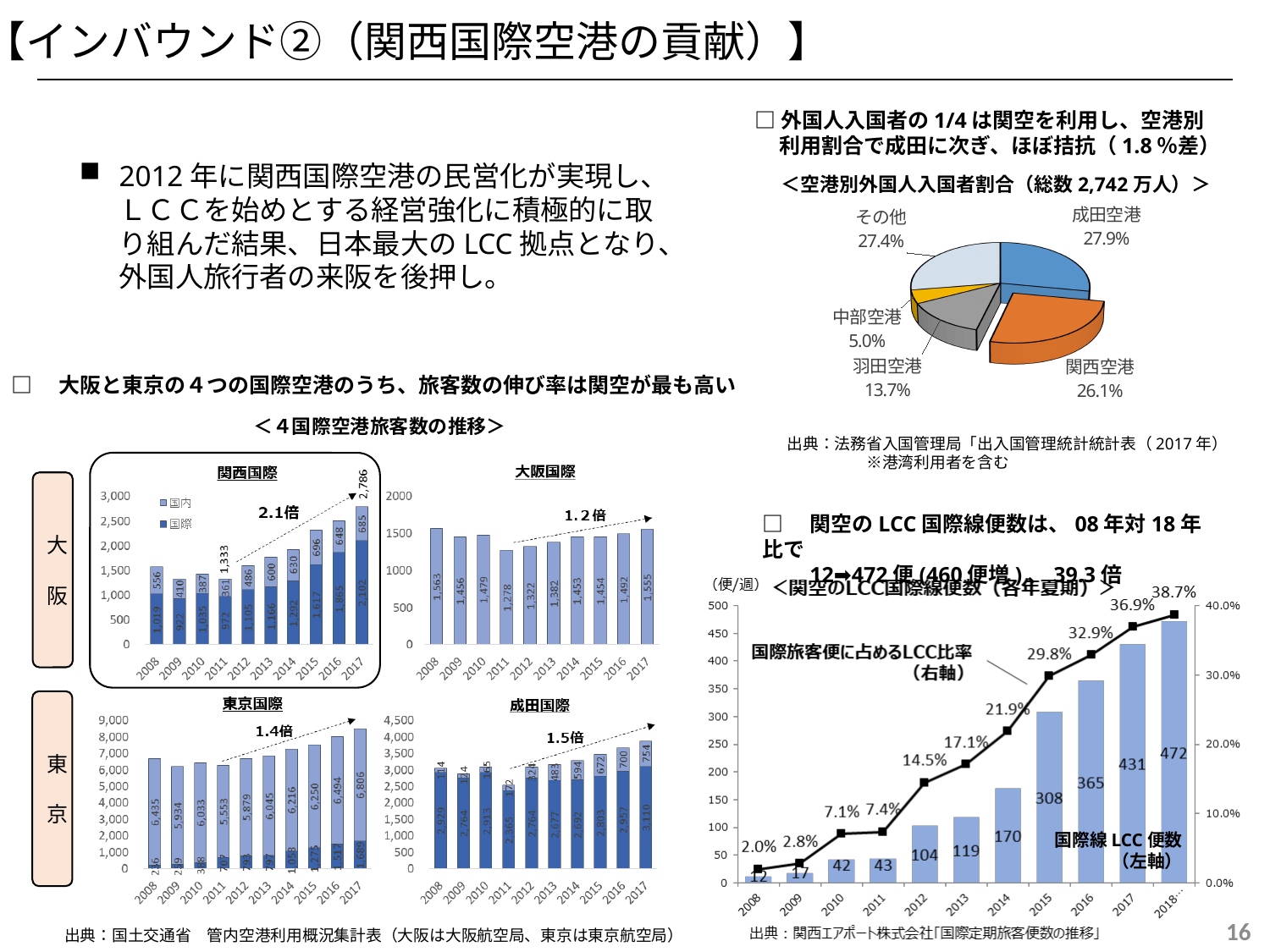
In the 関西国際 bar chart, how many series does the legend list? 2 In the 関空のLCC国際線便数 chart, what is the difference in LCC flights between 2017 and 2016? 66 In the 関空のLCC国際線便数 chart, what is the LCC share (line) for 2015? 29.8% In the 関空のLCC国際線便数 chart, how many years are plotted on the x axis? 11 In the pie chart 空港別外国人入国者割合, what share does 関西空港 have? 26.1% In the pie chart 空港別外国人入国者割合, what share does 成田空港 have? 27.9% In the 関空のLCC国際線便数 chart, do the LCC flight numbers rise or fall from 2008 to 2018? rise In the 関空のLCC国際線便数 chart, what is the number of LCC international flights (bar) for 2018? 472 In the pie chart 空港別外国人入国者割合, which airport has the smallest share? 中部空港 In the 関西国際 bar chart, what is the 国際 value for 2017? 2,102 In the 大阪国際 bar chart, which year has the lowest passenger number? 2011 In the pie chart 空港別外国人入国者割合, what is the difference between the shares of 羽田空港 and 中部空港? 8.7%